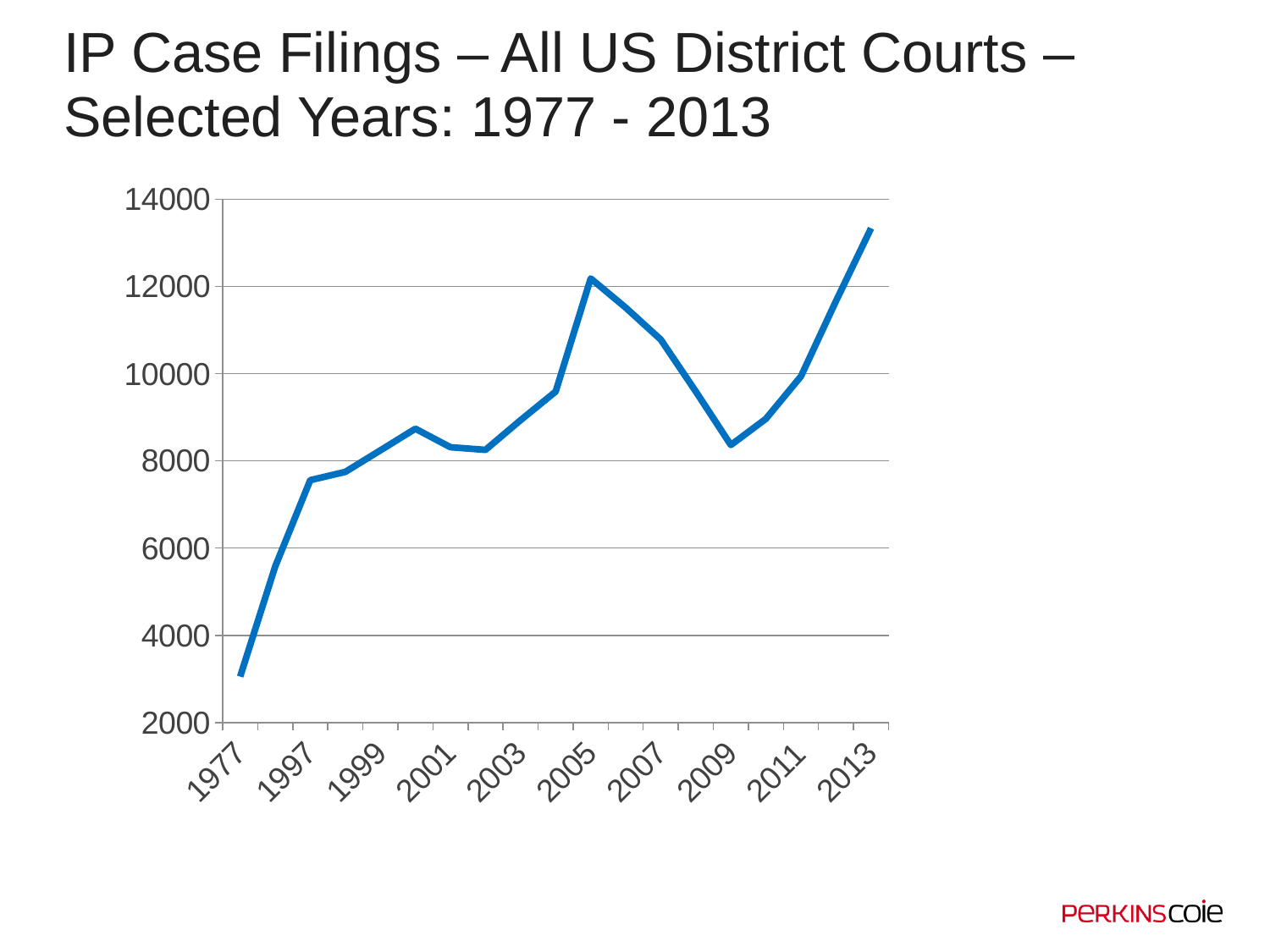
What kind of chart is shown on the slide? line chart Which year has the highest number of IP case filings? 2013 Is the value for 2009 greater or less than 10000? less How many year labels are shown on the x axis? 10 Which year has the lowest number of IP case filings? 1977 Overall, do IP case filings rise or fall from 1977 to 2013? rise What is the title of the chart? IP Case Filings – All US District Courts – Selected Years: 1977 - 2013 Is the value for 1977 greater or less than 4000? less Is the value for 2013 greater or less than 12000? greater Which year has more IP case filings, 2005 or 2009? 2005